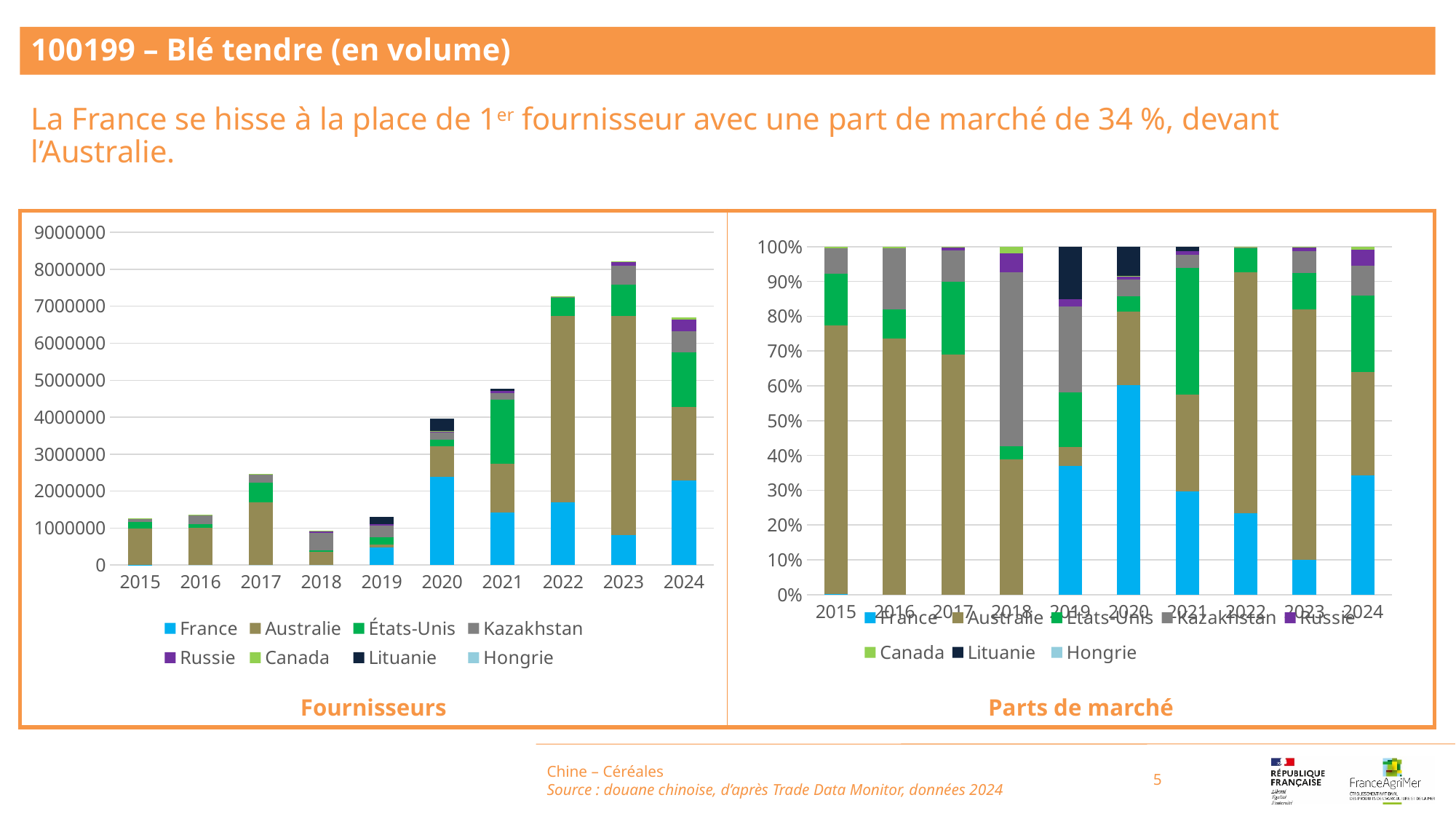
In the 'Fournisseurs' chart, is the total for 2021 greater or less than 5000000? less In the 'Fournisseurs' chart, which year has the highest total bar? 2023 In the 'Fournisseurs' chart, which year has the larger total bar, 2022 or 2021? 2022 What kind of chart is the 'Fournisseurs' chart? bar chart How many years are shown on the x axis of the 'Parts de marché' chart? 10 In the 'Parts de marché' chart, is the share for France in 2020 greater or less than 50%? greater Which colour represents France in the 'Parts de marché' chart? light blue In the 'Parts de marché' chart, is the share for Australie in 2015 greater or less than 70%? greater In the 'Fournisseurs' chart, which year has the lowest total bar? 2018 How many series does the legend of the 'Fournisseurs' chart list? 8